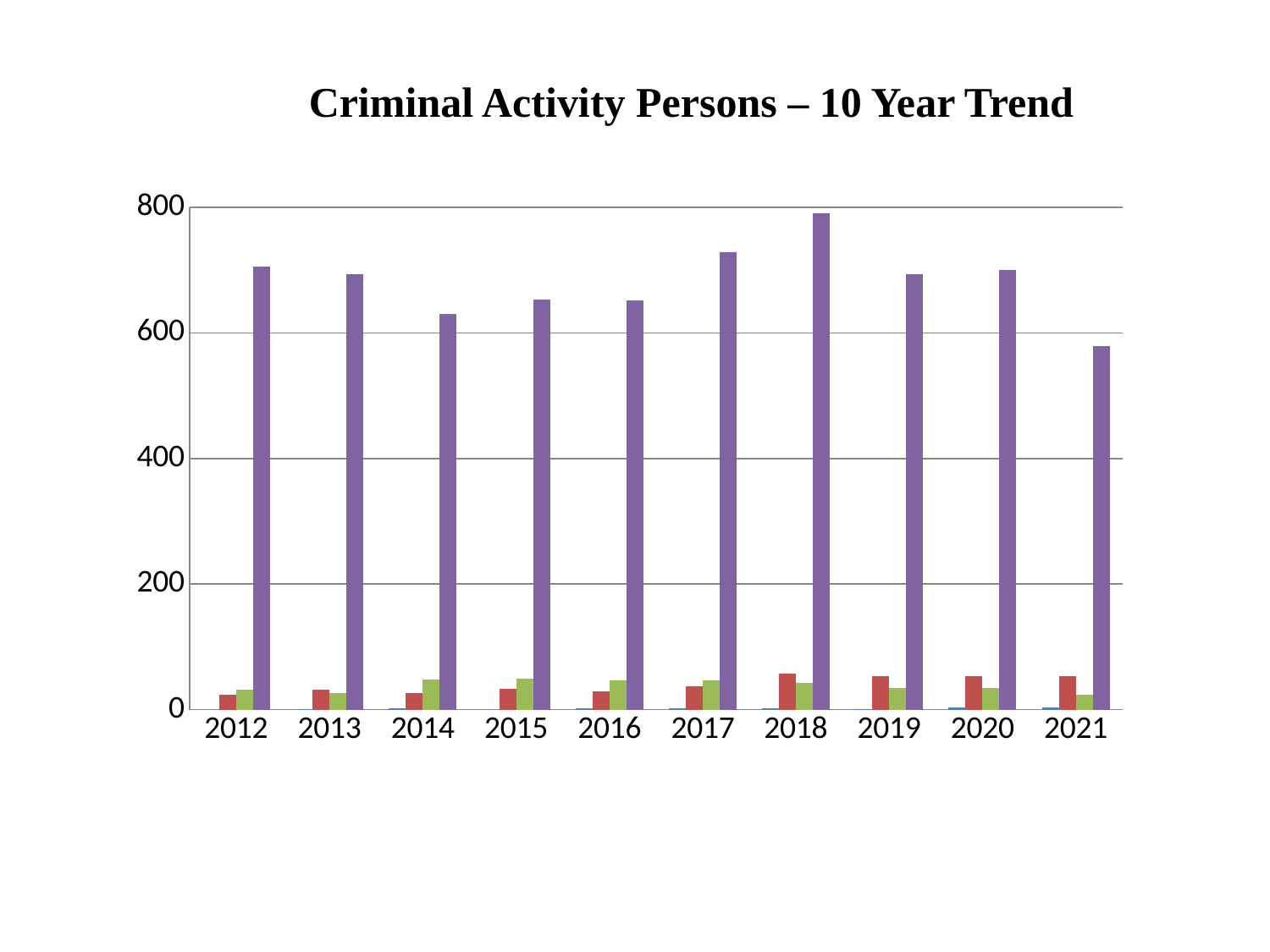
What kind of chart is shown on the slide? bar chart Is the purple bar for 2018 greater or less than 600? greater In which year is the purple bar the tallest? 2018 Which year has the taller purple bar, 2017 or 2016? 2017 Is the red bar for 2018 greater or less than 200? less Which year has the taller purple bar, 2012 or 2021? 2012 Is the purple bar for 2021 greater or less than 400? greater In which year is the purple bar the shortest? 2021 How many years are shown on the x axis of the chart? 10 What is the title of the chart? Criminal Activity Persons – 10 Year Trend What is the highest value shown on the y axis of the chart? 800